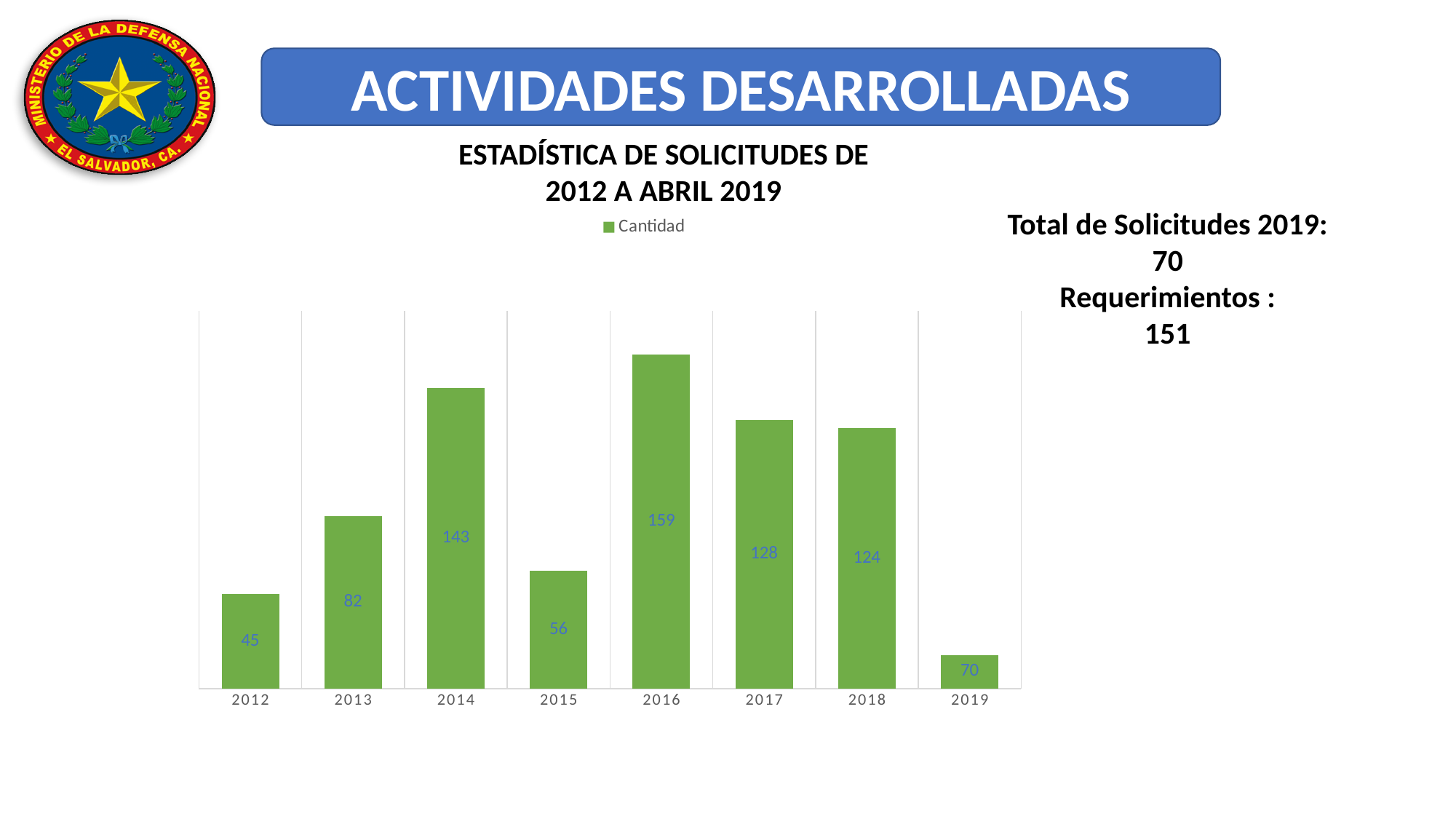
What is the difference between the values for 2017 and 2018? 4 What is the value for 2019? 70 How many series does the legend list? 1 What is the value for 2014? 143 What kind of chart is shown? bar chart What is the value for 2015? 56 Which is larger, the value for 2013 or the value for 2015? 2013 How many years are shown on the x axis? 8 What is the name of the series in the legend? Cantidad Which year has the highest value? 2016 What is the difference between the values for 2016 and 2012? 114